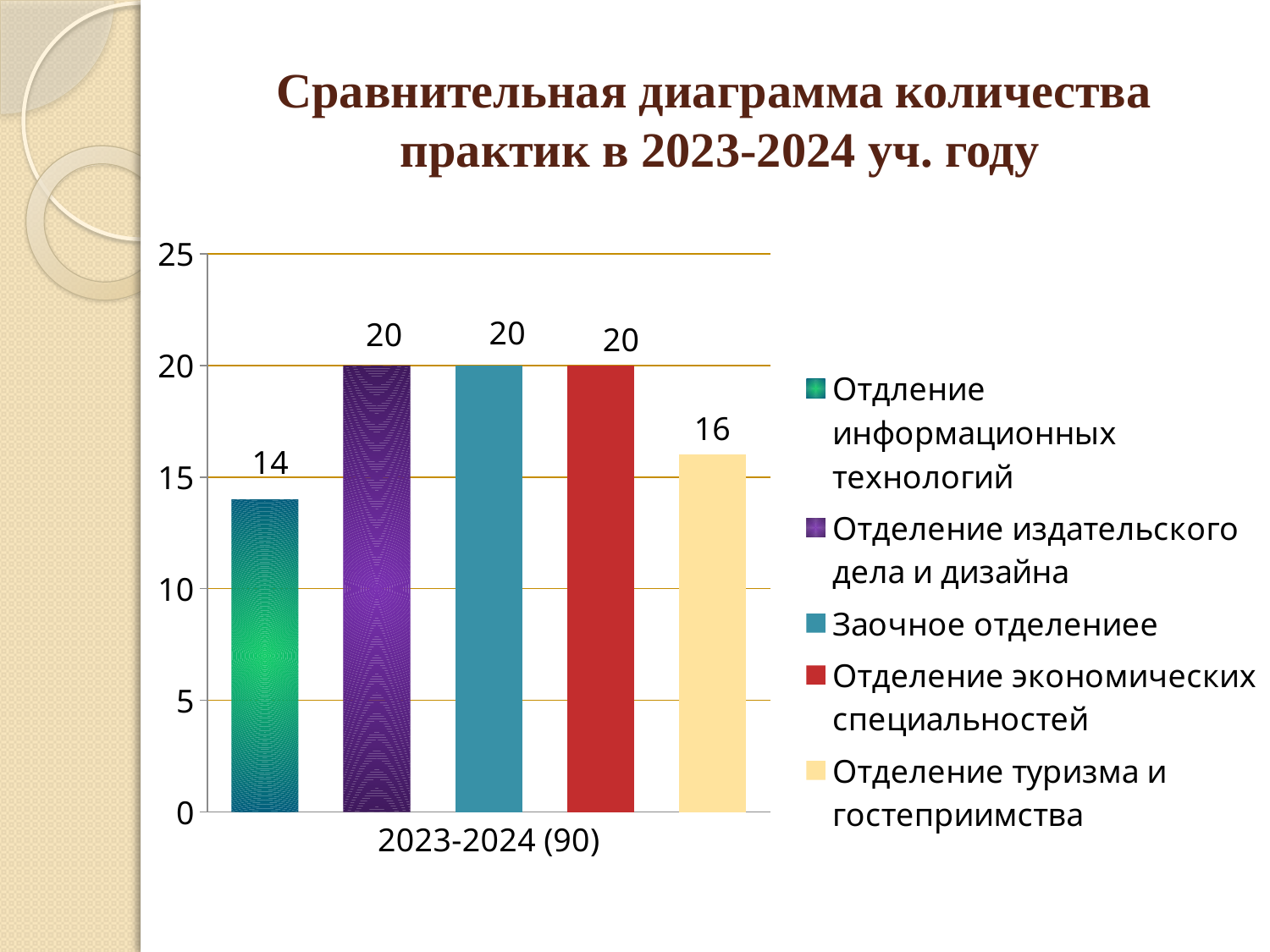
What is the title of the chart? Сравнительная диаграмма количества практик в 2023-2024 уч. году What is the category label on the x axis? 2023-2024 (90) What kind of chart is shown on the slide? bar chart Is the value for Отдление информационных технологий greater or less than 15? less What is the value for Заочное отделениее? 20 What is the value for Отделение туризма и гостеприимства? 16 Which is larger, the value for Отделение туризма и гостеприимства or the value for Отдление информационных технологий? Отделение туризма и гостеприимства What is the value for Отдление информационных технологий? 14 How many series does the legend list? 5 Which series has the lowest value? Отдление информационных технологий What is the difference between the values for Отделение издательского дела и дизайна and Отделение туризма и гостеприимства? 4 What is the difference between the values for Отделение экономических специальностей and Отдление информационных технологий? 6